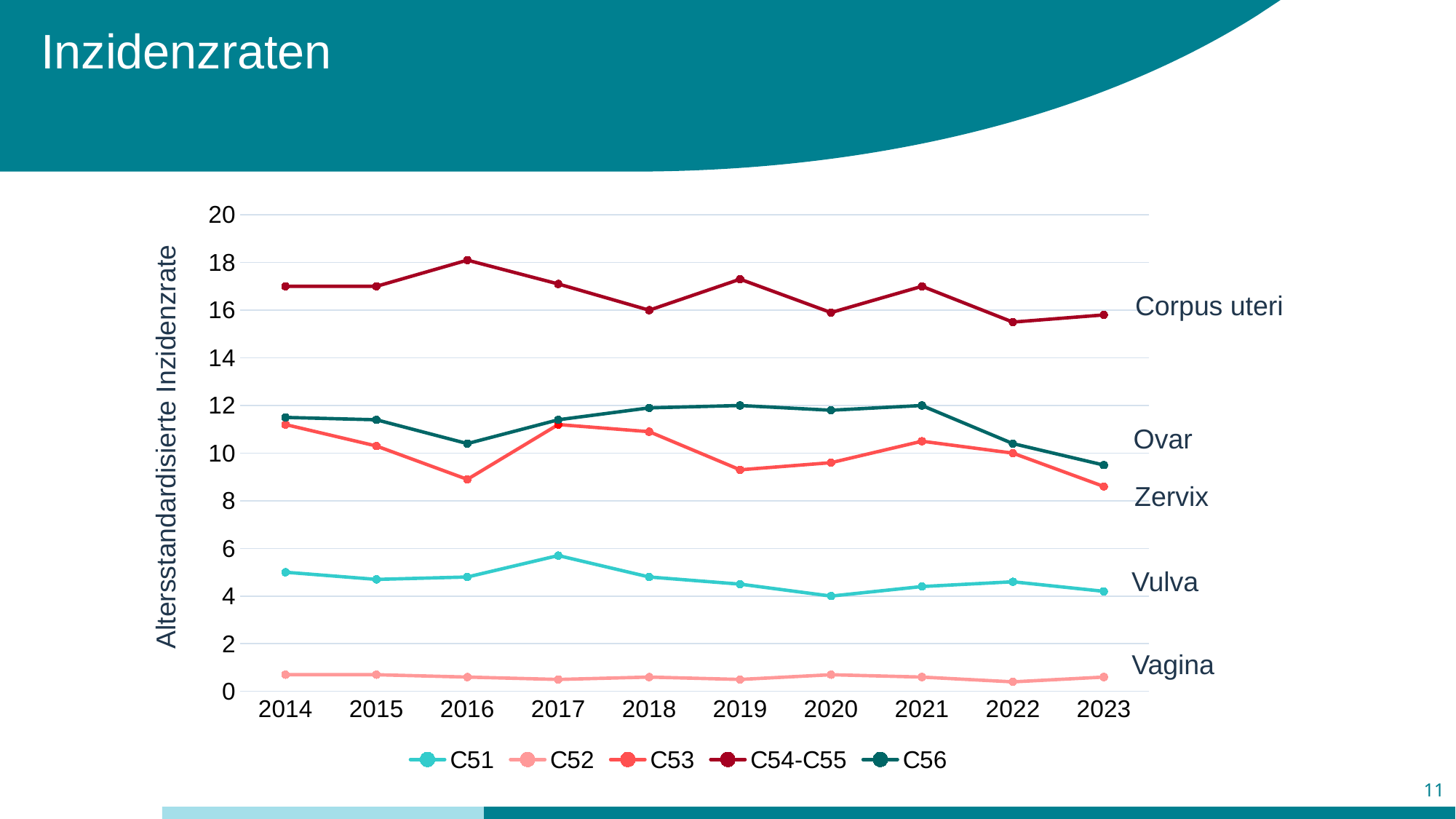
Is the value for C52 in 2020 greater or less than 2? less Which series has the lowest values across all years? C52 What is the label on the y axis? Altersstandardisierte Inzidenzrate Is the value for C51 in 2017 greater or less than 4? greater Is the value for C54-C55 in 2014 greater or less than 16? greater What kind of chart is shown on the slide? line chart How many series does the legend list? 5 Which series has the highest values across all years? C54-C55 Does the C54-C55 line rise or fall overall from 2014 to 2023? fall In 2019, which series has the larger value, C56 or C53? C56 How many years are shown on the x axis? 10